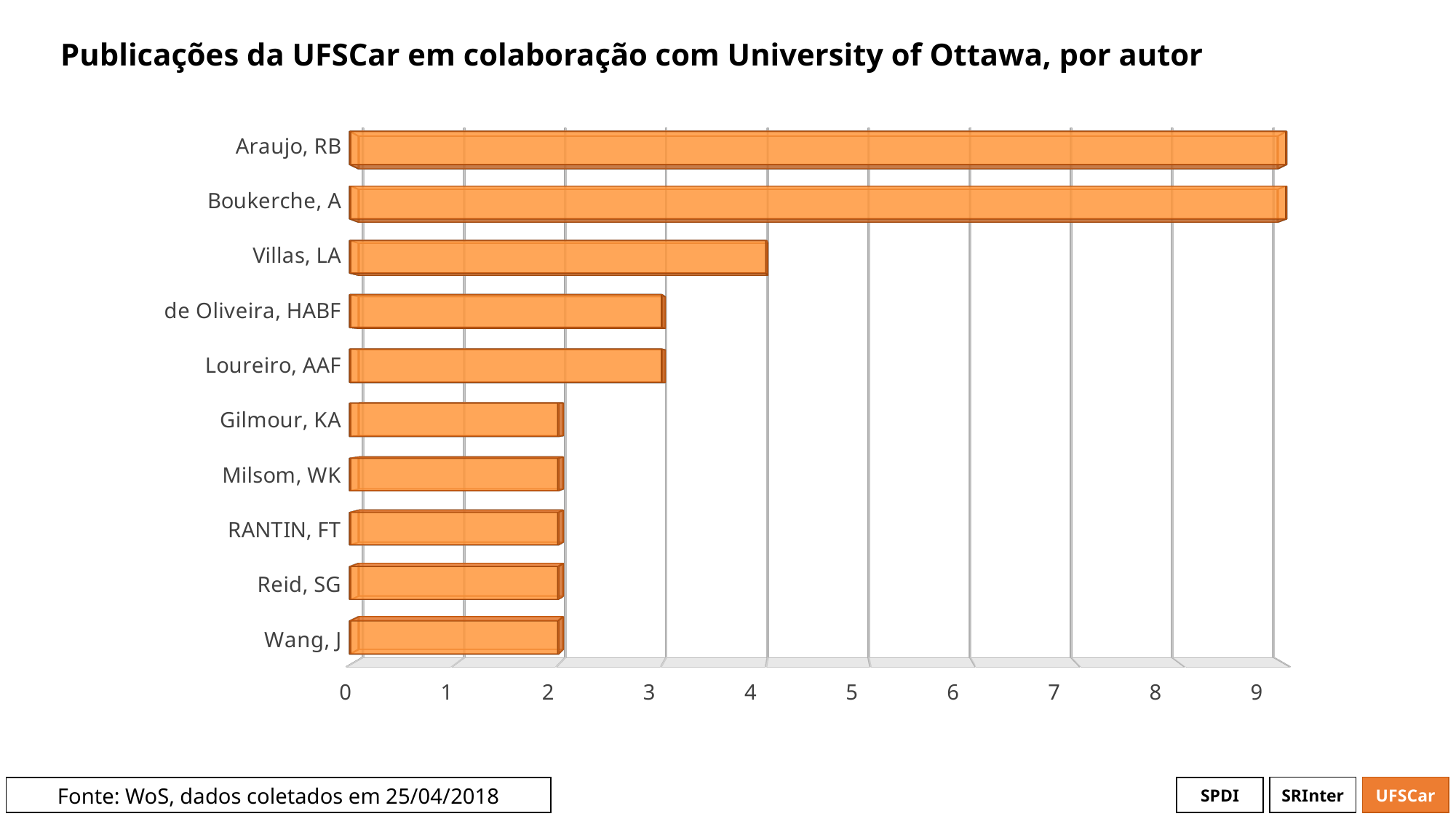
How many publications does Loureiro, AAF have? 3 Do the bar values rise or fall going from the top author to the bottom author? fall Is the value for Gilmour, KA greater or less than 3? less How many publications does Villas, LA have? 4 How many publications does Araujo, RB have? 9 What is the difference between the publications of Boukerche, A and Villas, LA? 5 Is the value for Boukerche, A greater or less than 5? greater What is the title of the chart? Publicações da UFSCar em colaboração com University of Ottawa, por autor What kind of chart is shown on the slide? bar chart How many publications does Wang, J have? 2 How many authors are listed in the chart? 10 Who has more publications, Villas, LA or de Oliveira, HABF? Villas, LA